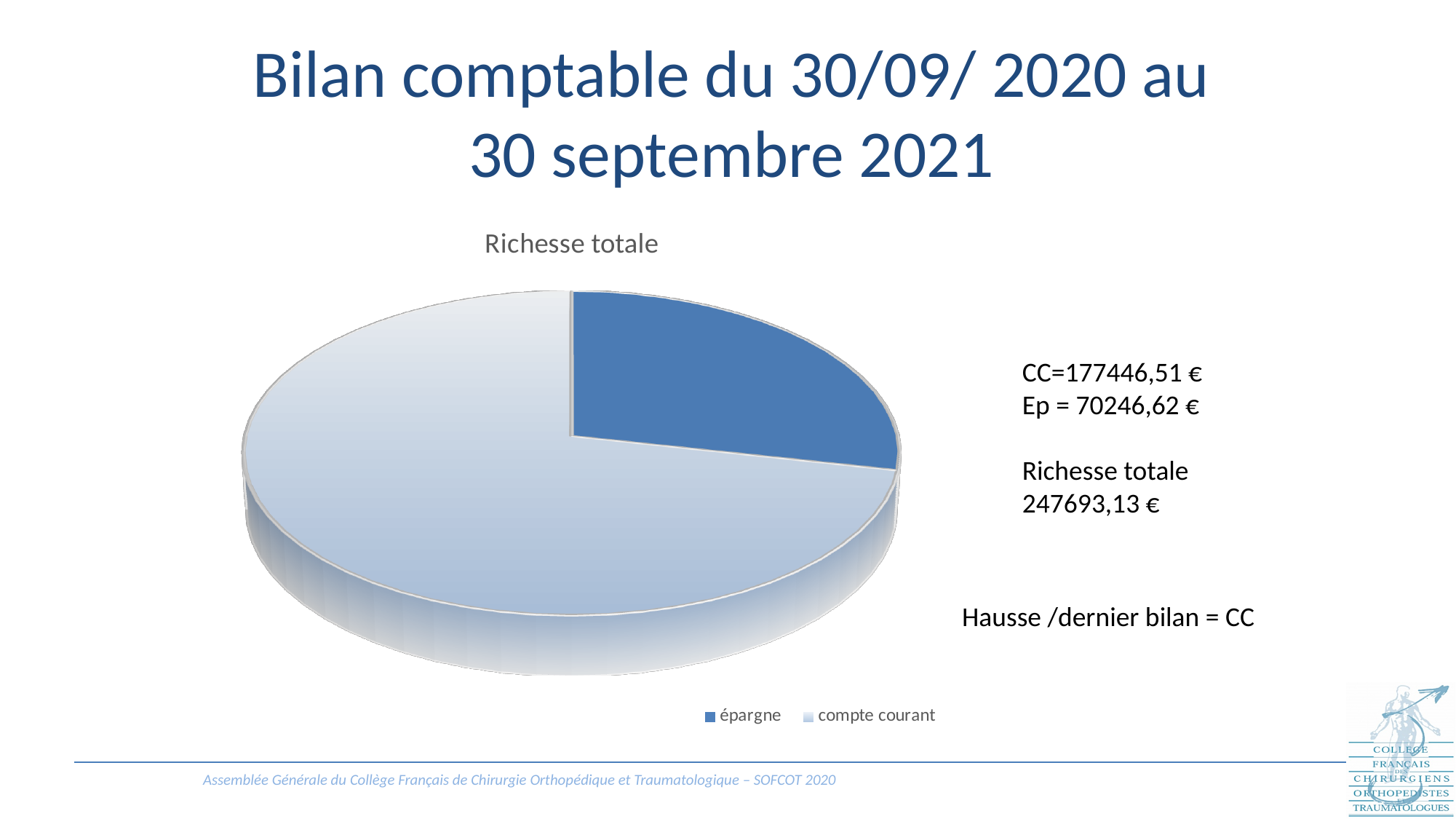
What is the value given for Ep (épargne) on the slide? 70246,62 € Which legend entry is shown in the darker blue colour? épargne How many entries does the legend of the pie chart list? 2 Which slice of the pie chart is the largest? compte courant How many slices does the pie chart have? 2 What is the title of the pie chart? Richesse totale Which is larger in the pie chart, épargne or compte courant? compte courant What is the value given for CC (compte courant) on the slide? 177446,51 € Which slice of the pie chart is the smallest? épargne By how much does the CC value exceed the Ep value? 107199,89 € What is the total 'Richesse totale' shown on the slide? 247693,13 € What kind of chart is shown on the slide? pie chart